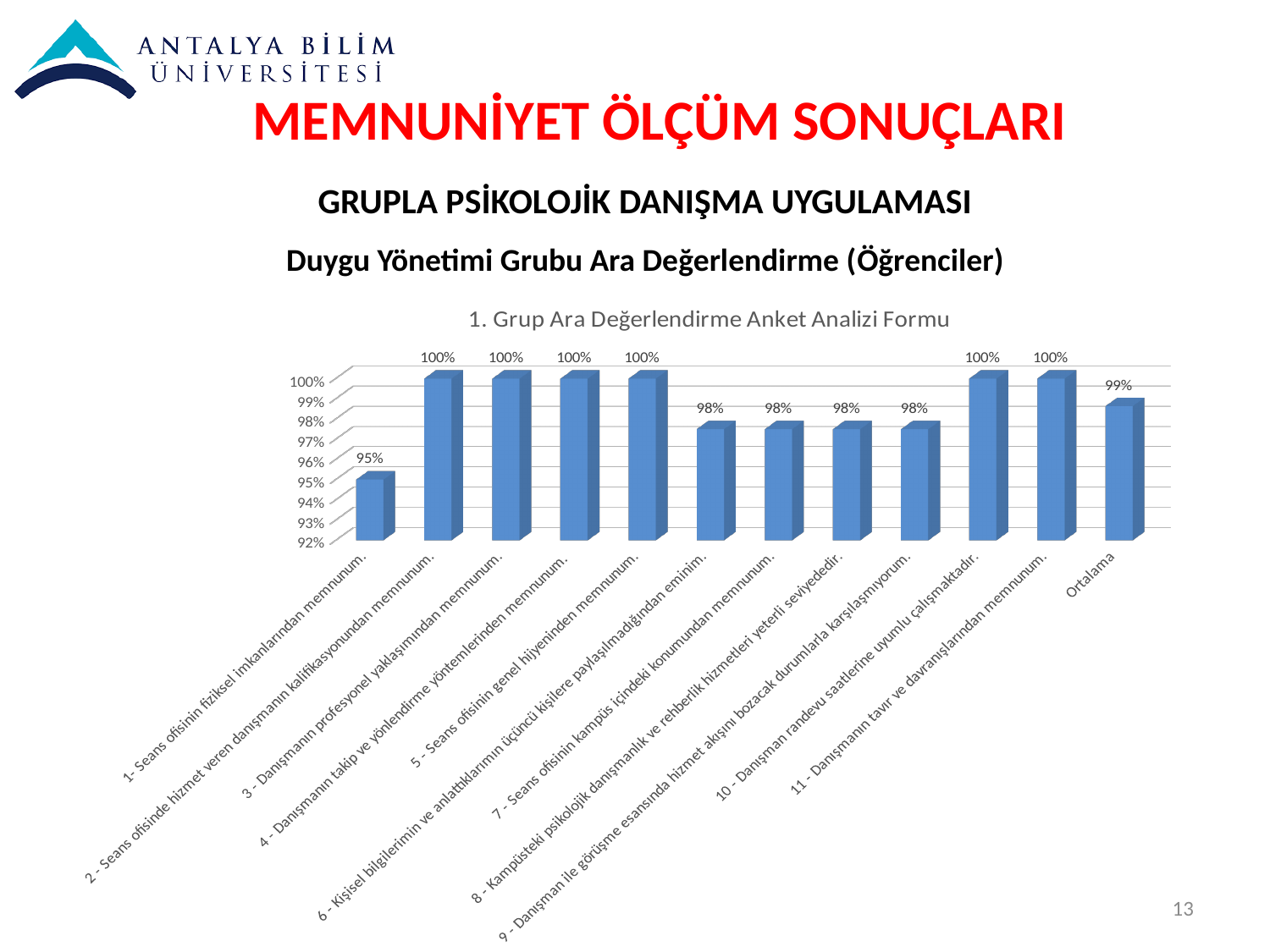
How many bars are plotted in the chart? 12 What is the value for "10 - Danışman randevu saatlerine uyumlu çalışmaktadır."? 100% What is the value for "6 - Kişisel bilgilerimin ve anlattıklarımın üçüncü kişilere paylaşılmadığından eminim."? 98% Is the value for "1 - Seans ofisinin fiziksel imkanlarından memnunum." greater or less than 97%? less What is the difference between the value for "Ortalama" and the value for "1 - Seans ofisinin fiziksel imkanlarından memnunum."? 4% What is the title of the chart on the slide? 1. Grup Ara Değerlendirme Anket Analizi Formu How many bars in the chart have a value of 100%? 6 What is the value for "1 - Seans ofisinin fiziksel imkanlarından memnunum."? 95% What kind of chart is shown on the slide? bar chart What is the value for "Ortalama"? 99% Which category has the lowest value in the chart? 1 - Seans ofisinin fiziksel imkanlarından memnunum. Which is larger: the value for "2 - Seans ofisinde hizmet veren danışmanın kalifikasyonundan memnunum." or the value for "7 - Seans ofisinin kampüs içindeki konumundan memnunum."? 2 - Seans ofisinde hizmet veren danışmanın kalifikasyonundan memnunum.